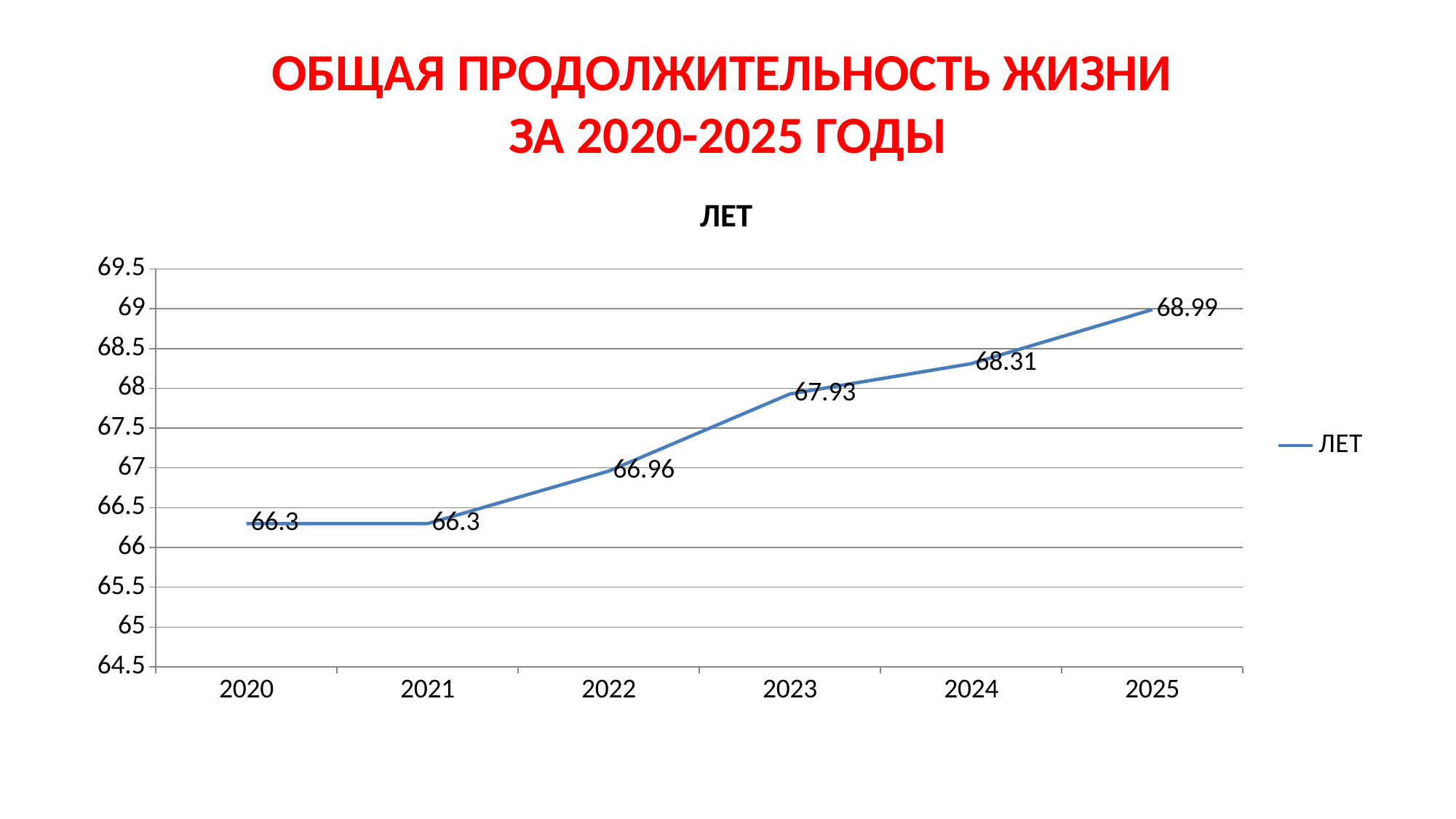
How many series does the legend list? 1 How many years are plotted on the x axis? 6 What is the difference between the values for 2025 and 2020? 2.69 Is the value for 2023 greater or less than 67.5? greater What is the value for 2020? 66.3 What is the value for 2025? 68.99 What kind of chart is shown? line chart What is the value for 2022? 66.96 Which year has the highest value? 2025 What is the difference between the values for 2023 and 2022? 0.97 Which is larger, the value for 2024 or the value for 2023? 2024 Do the values rise or fall from 2021 to 2025? rise